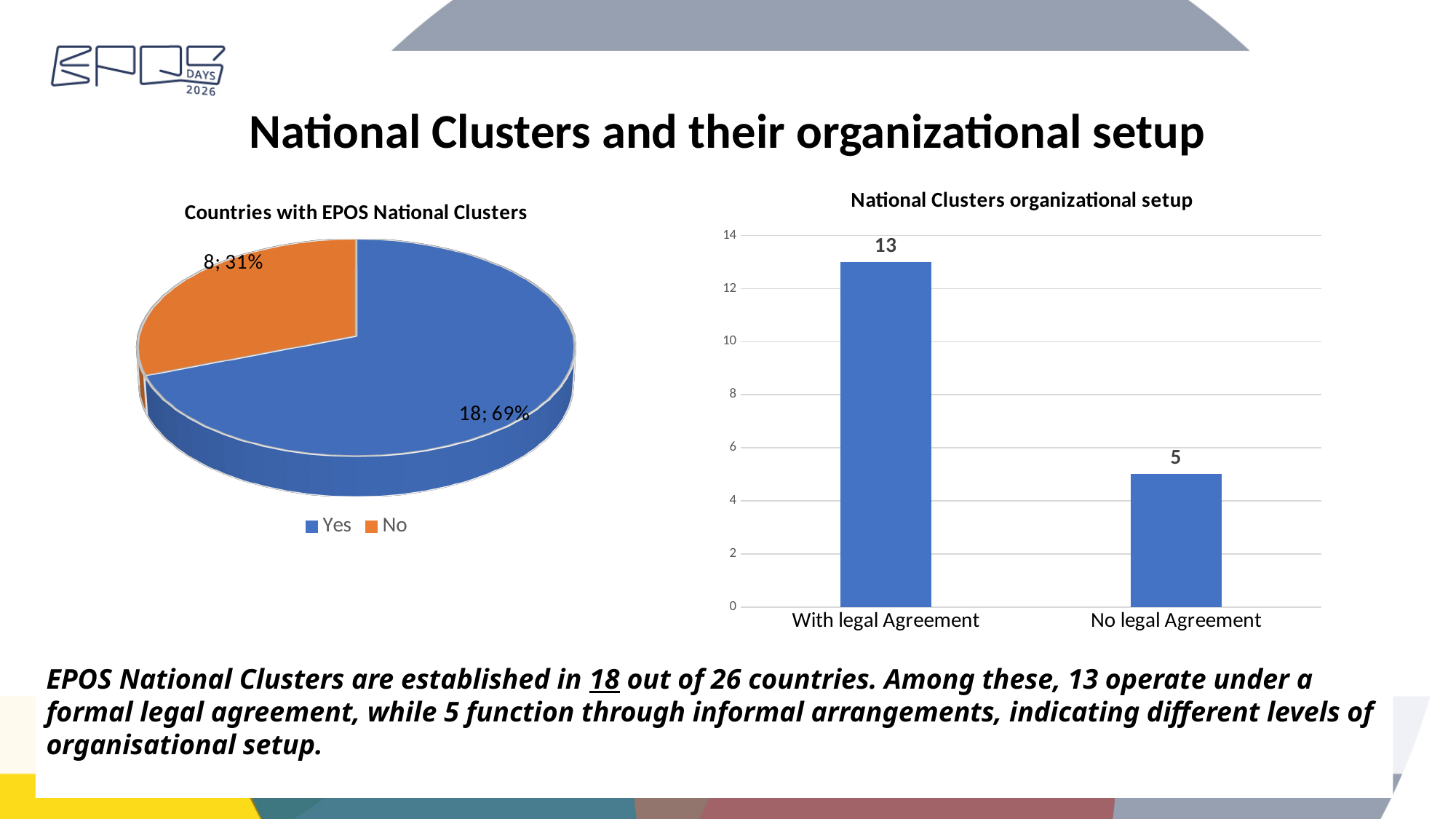
In the 'National Clusters organizational setup' chart, how many categories are shown on the x axis? 2 In the 'Countries with EPOS National Clusters' chart, what kind of chart is shown? pie chart In the 'Countries with EPOS National Clusters' chart, how many countries are in the 'No' slice? 8 In the 'Countries with EPOS National Clusters' chart, how many entries does the legend list? 2 In the 'National Clusters organizational setup' chart, what kind of chart is shown? bar chart In the 'Countries with EPOS National Clusters' chart, what share of the pie is 'Yes'? 69% In the 'National Clusters organizational setup' chart, what is the value for 'No legal Agreement'? 5 In the 'Countries with EPOS National Clusters' chart, what colour is the 'No' slice? orange In the 'National Clusters organizational setup' chart, what is the difference between 'With legal Agreement' and 'No legal Agreement'? 8 In the 'Countries with EPOS National Clusters' chart, which slice is larger, 'Yes' or 'No'? Yes In the 'Countries with EPOS National Clusters' chart, what share of the pie is 'No'? 31% In the 'National Clusters organizational setup' chart, what is the value for 'With legal Agreement'? 13